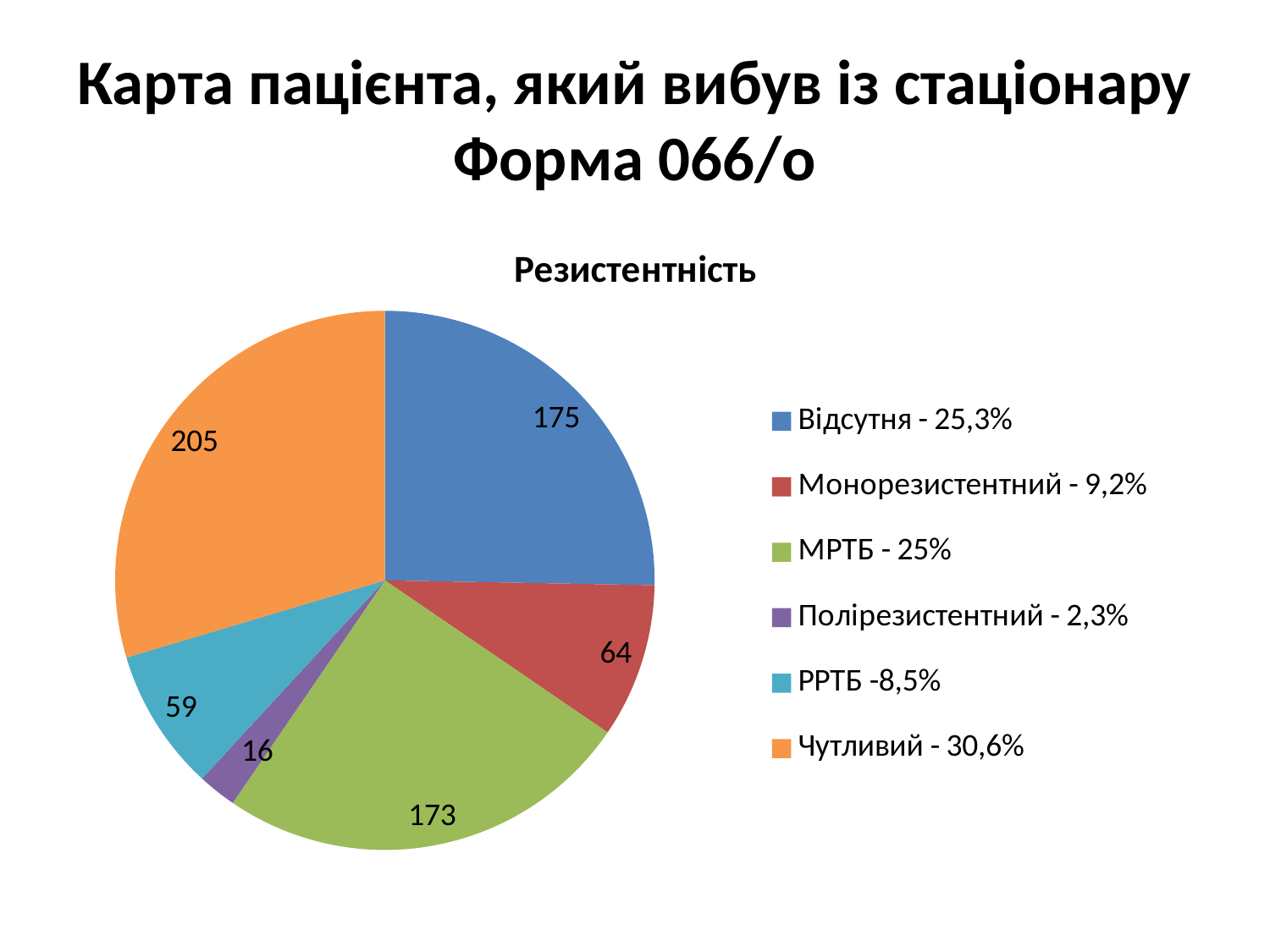
What is the title of the chart? Резистентність What is the value for Монорезистентний? 64 Which category has the largest slice? Чутливий What share of the pie does МРТБ represent, according to the legend? 25% Which category has the smallest slice? Полірезистентний What is the value for РРТБ? 59 What is the difference between the values for Чутливий and Відсутня? 30 Which is larger, the value for Монорезистентний or the value for РРТБ? Монорезистентний What is the total of all the slice values in the pie chart? 692 What type of chart is shown on the slide? pie chart How many slices does the pie chart have? 6 What is the value for Чутливий? 205